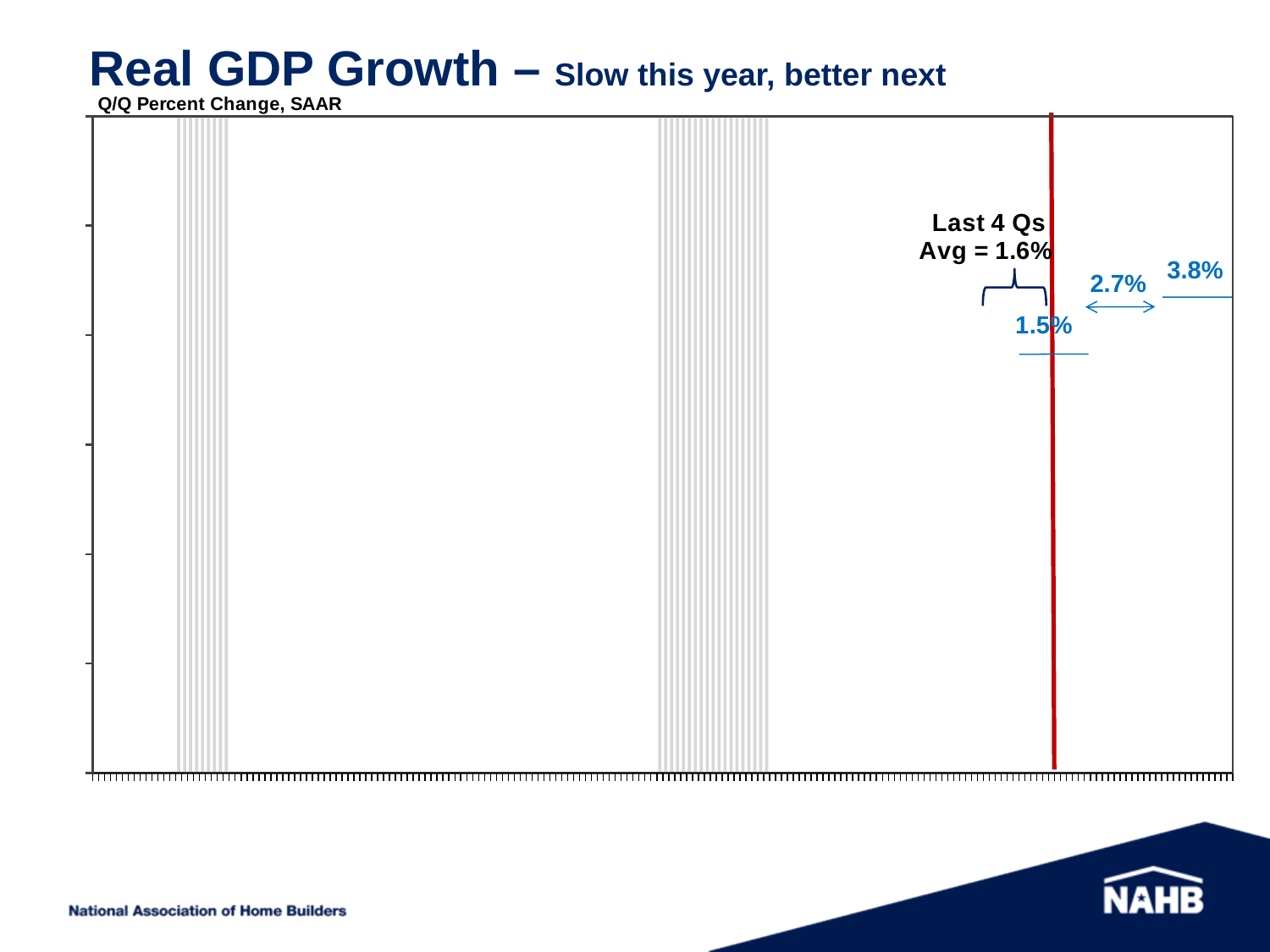
What is the difference between the annotated values 2.7% and 1.5%? 1.2 percentage points What units does the chart's subtitle say the data is measured in? Q/Q Percent Change, SAAR Is the annotated value of 1.5% greater or less than the last-4-quarter average of 1.6%? less What is the highest annotated growth value shown at the far right of the chart? 3.8% What growth value is annotated just to the right of the red vertical line, beneath the bracket? 1.5% Which annotated value is larger, 2.7% or 3.8%? 3.8% Do the annotated values to the right of the red vertical line rise or fall from left to right? rise What is the difference between the annotated values 3.8% and 2.7%? 1.1 percentage points What is the lowest of the three blue annotated values to the right of the red vertical line? 1.5% What is the middle of the three blue annotated values to the right of the red vertical line? 2.7% What is the title of the slide's chart? Real GDP Growth – Slow this year, better next According to the annotation on the chart, what is the average real GDP growth over the last 4 quarters? 1.6%